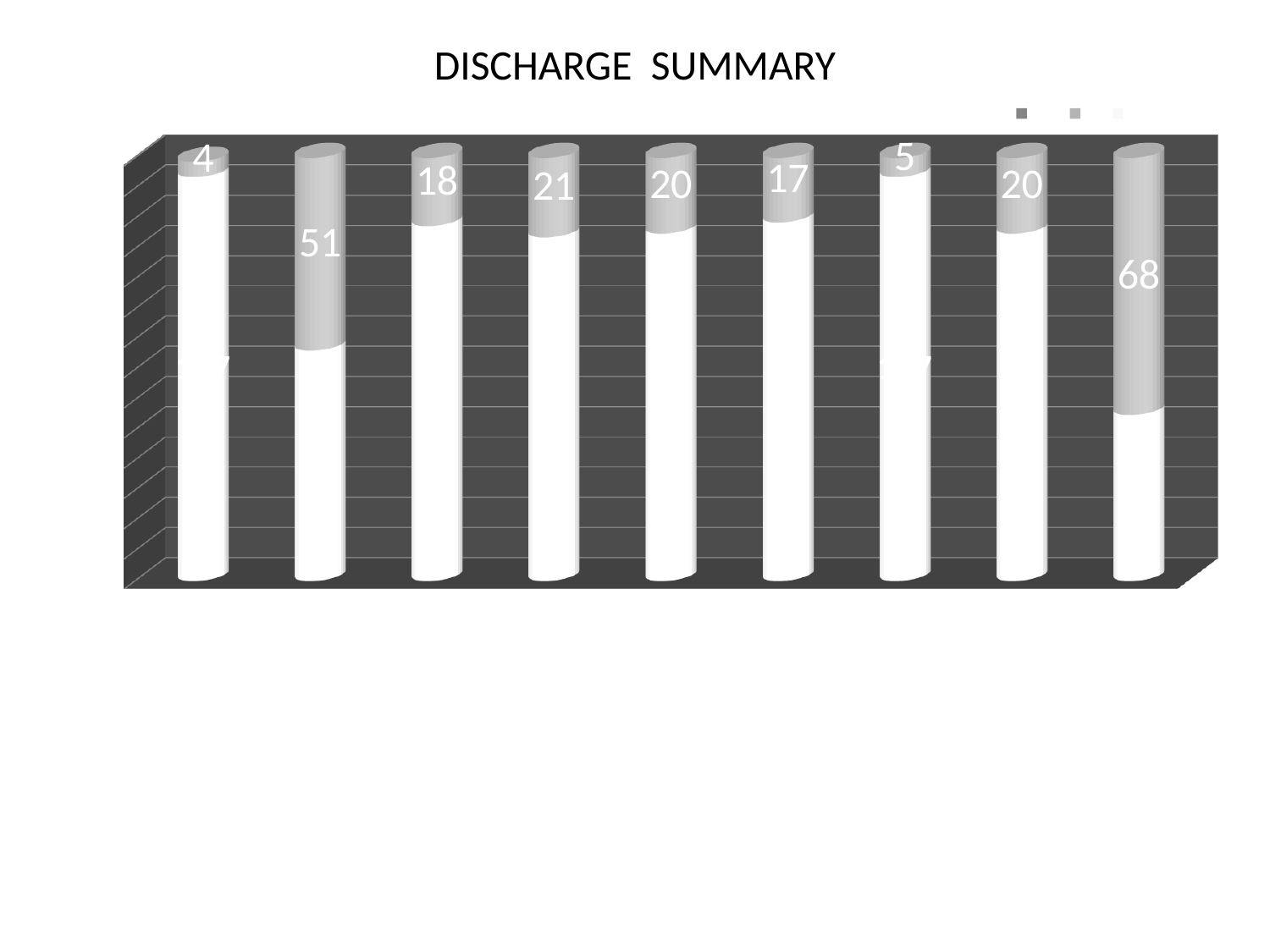
What is the title of the chart? DISCHARGE SUMMARY What is the data label on the rightmost bar? 68 What is the data label on the seventh bar from the left? 5 How many bars are plotted in the chart? 9 How many series markers does the legend show? 3 What is the lowest data label shown on the chart? 4 What kind of chart is shown on the slide? bar chart What is the difference between the data labels on the rightmost bar and the second bar from the left? 17 What is the data label on the leftmost bar? 4 What is the data label on the second bar from the left? 51 What is the highest data label shown on the chart? 68 Which has the larger data label, the second bar from the left or the rightmost bar? the rightmost bar